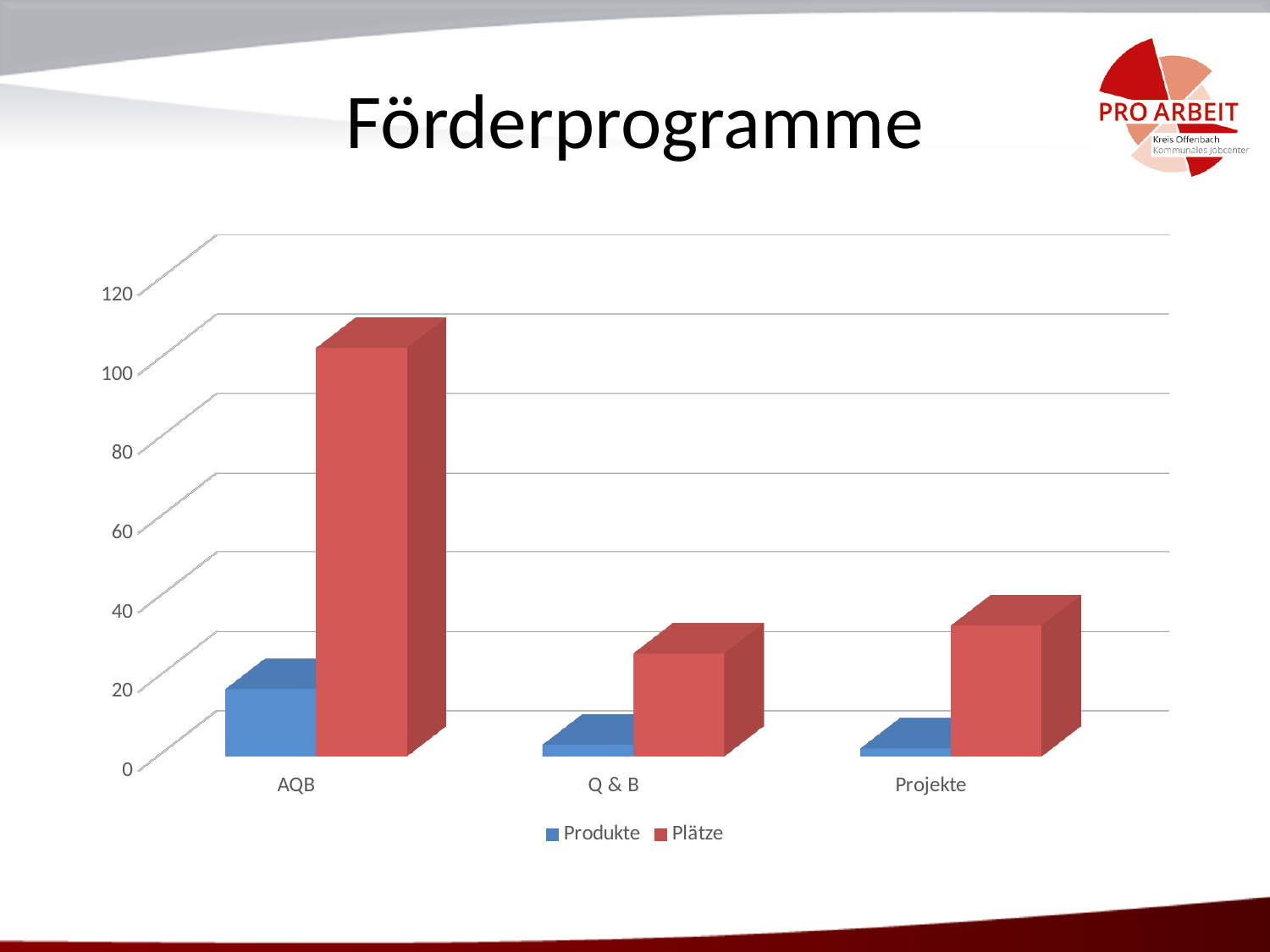
Is the Produkte value for AQB greater or less than 40? less Which category has the lowest value for Plätze? Q & B Is the Plätze value for Projekte greater or less than 20? greater Is the Plätze value for AQB greater or less than 80? greater How many categories are shown on the x axis of the chart? 3 Which series is shown in red in the chart? Plätze How many series does the chart's legend list? 2 Which category has the highest value for Plätze? AQB What is the title of the slide containing the chart? Förderprogramme Which category has the highest value for Produkte? AQB What kind of chart is shown on the slide? bar chart Which is larger: the Plätze value for Projekte or the Plätze value for Q & B? Projekte